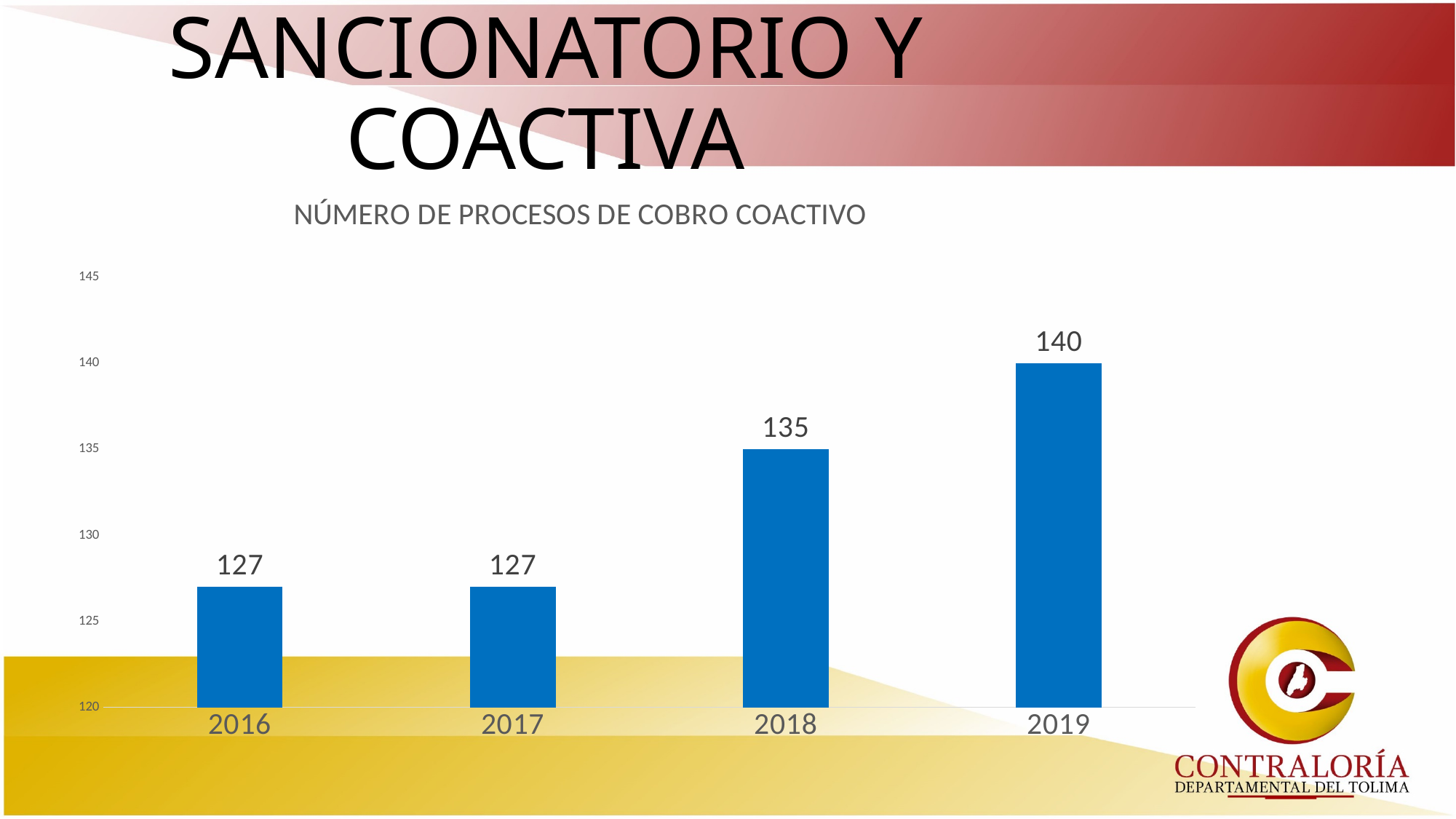
What kind of chart is shown? bar chart What is the title of the chart? NÚMERO DE PROCESOS DE COBRO COACTIVO What is the difference between the values for 2018 and 2017? 8 Do the values rise or fall from 2016 to 2019? rise What is the value for 2018? 135 What is the difference between the values for 2019 and 2018? 5 Which is larger, the value for 2017 or the value for 2018? 2018 How many years are shown on the x axis? 4 What is the value for 2019? 140 What is the value for 2016? 127 Which year has the highest value? 2019 Is the value for 2018 greater or less than 130? greater